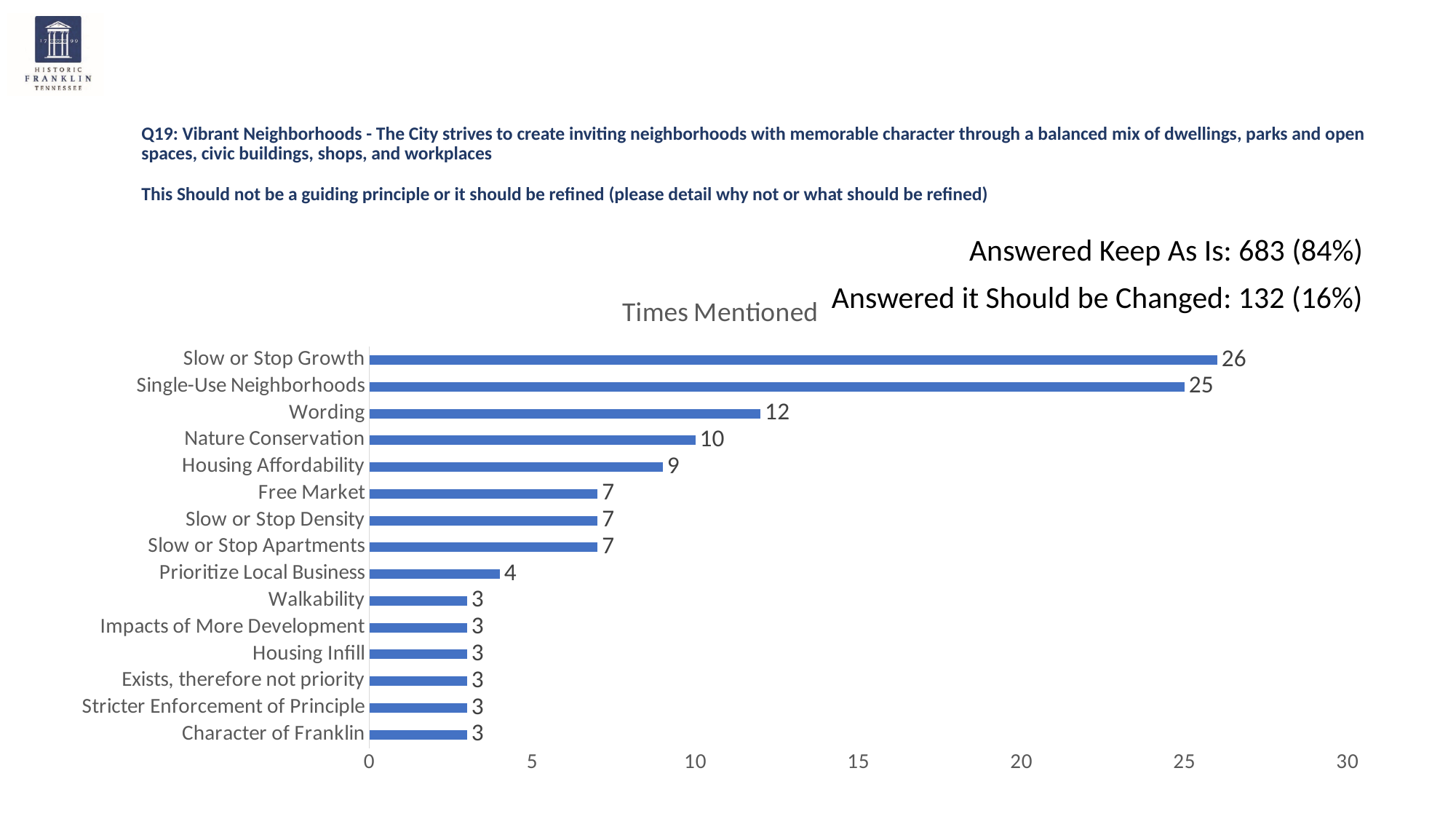
What is the value for Wording? 12 What is the value for Prioritize Local Business? 4 Is the value for Single-Use Neighborhoods greater or less than 20? greater What is the value for Housing Affordability? 9 How many categories are plotted in the chart? 15 What is the difference between the values for Wording and Nature Conservation? 2 Which category has the highest number of times mentioned? Slow or Stop Growth What kind of chart is shown on the slide? bar chart What is the chart's title? Times Mentioned How many times was Slow or Stop Growth mentioned? 26 Which is larger, the value for Nature Conservation or the value for Free Market? Nature Conservation What is the difference between the values for Slow or Stop Growth and Single-Use Neighborhoods? 1